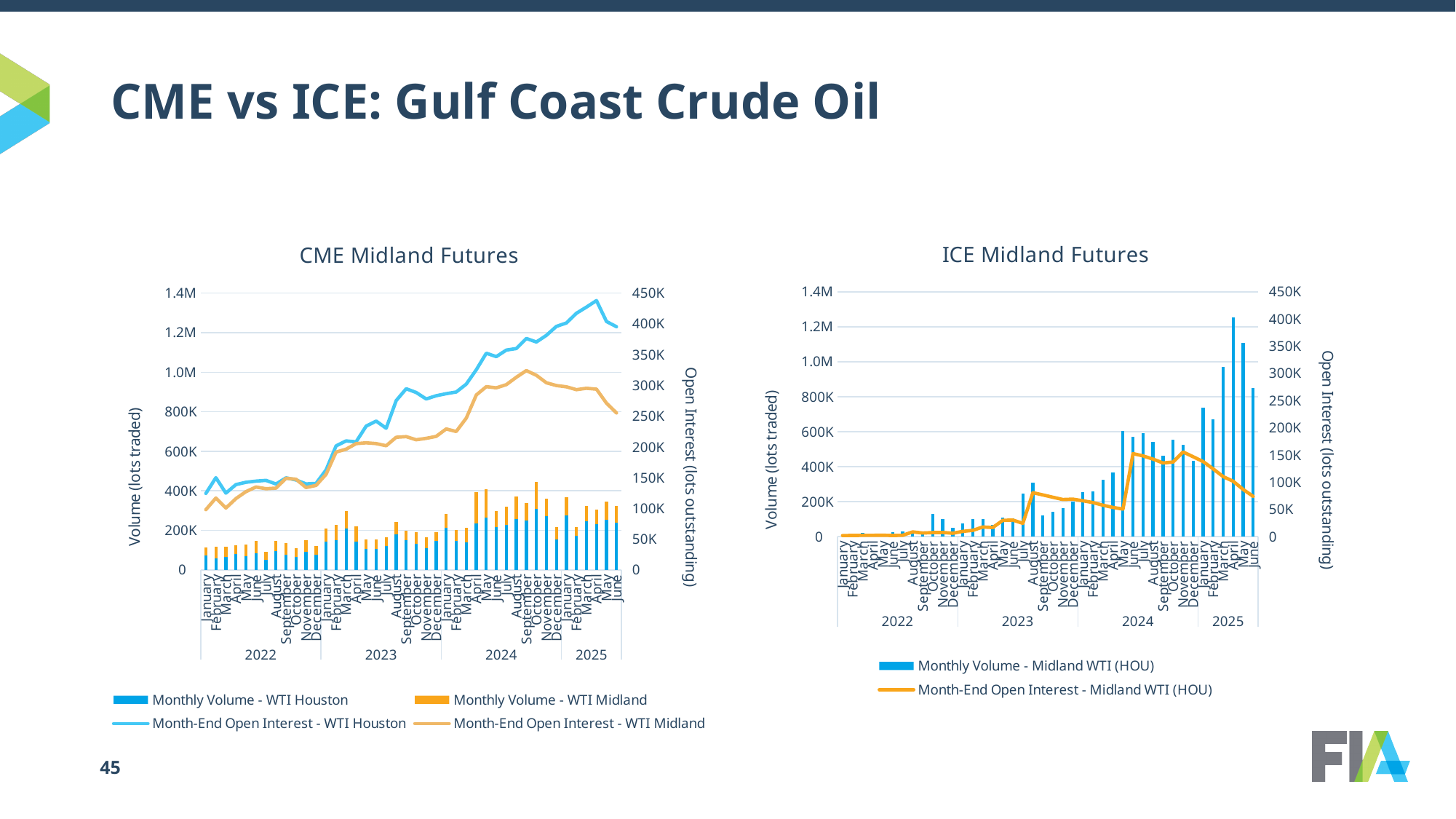
In the ICE Midland Futures chart, is the monthly volume for April 2025 greater or less than 1.0M? greater In the ICE Midland Futures chart, is the month-end open interest for June 2025 greater or less than 100K? less How many series does the legend of the ICE Midland Futures chart list? 2 In the ICE Midland Futures chart, does the month-end open interest rise or fall from January 2025 to June 2025? fall What is the label of the right-hand vertical axis on the ICE Midland Futures chart? Open Interest (lots outstanding) What kind of chart is the CME Midland Futures chart? A combined bar and line chart In the ICE Midland Futures chart, which month has the highest monthly volume? April 2025 How many series does the legend of the CME Midland Futures chart list? 4 In the CME Midland Futures chart, is the month-end open interest for WTI Houston in March 2025 greater or less than 400K? greater In the CME Midland Futures chart, does the month-end open interest for WTI Houston rise or fall from January 2022 to December 2024? rise In the ICE Midland Futures chart, which is larger, the monthly volume for April 2025 or for May 2025? April 2025 In the CME Midland Futures chart, which is larger in June 2025, the month-end open interest for WTI Houston or for WTI Midland? WTI Houston